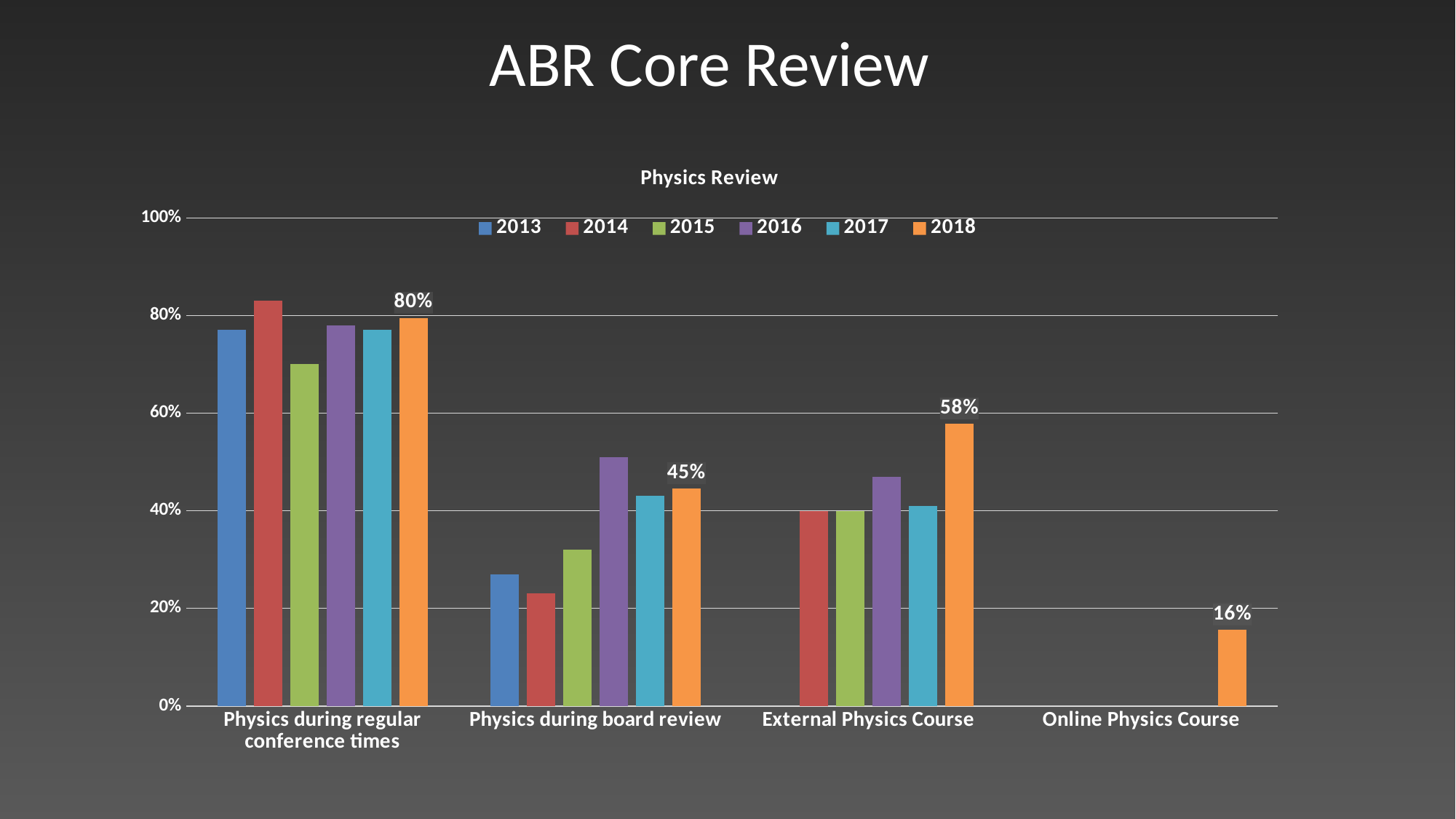
What is the 2018 value for Physics during regular conference times? 80% What is the difference between the 2018 values for Physics during regular conference times and Physics during board review? 35 percentage points Is the 2014 value for Physics during regular conference times greater or less than 80%? greater How many series does the legend list? 6 Which category has the lowest 2018 value? Online Physics Course Which is larger for 2018: External Physics Course or Physics during board review? External Physics Course What is the 2018 value for Online Physics Course? 16% What is the 2018 value for Physics during board review? 45% Is the 2013 value for Physics during board review greater or less than 40%? less How many categories are shown on the x axis? 4 Which category has the highest 2018 value? Physics during regular conference times What is the 2018 value for External Physics Course? 58%